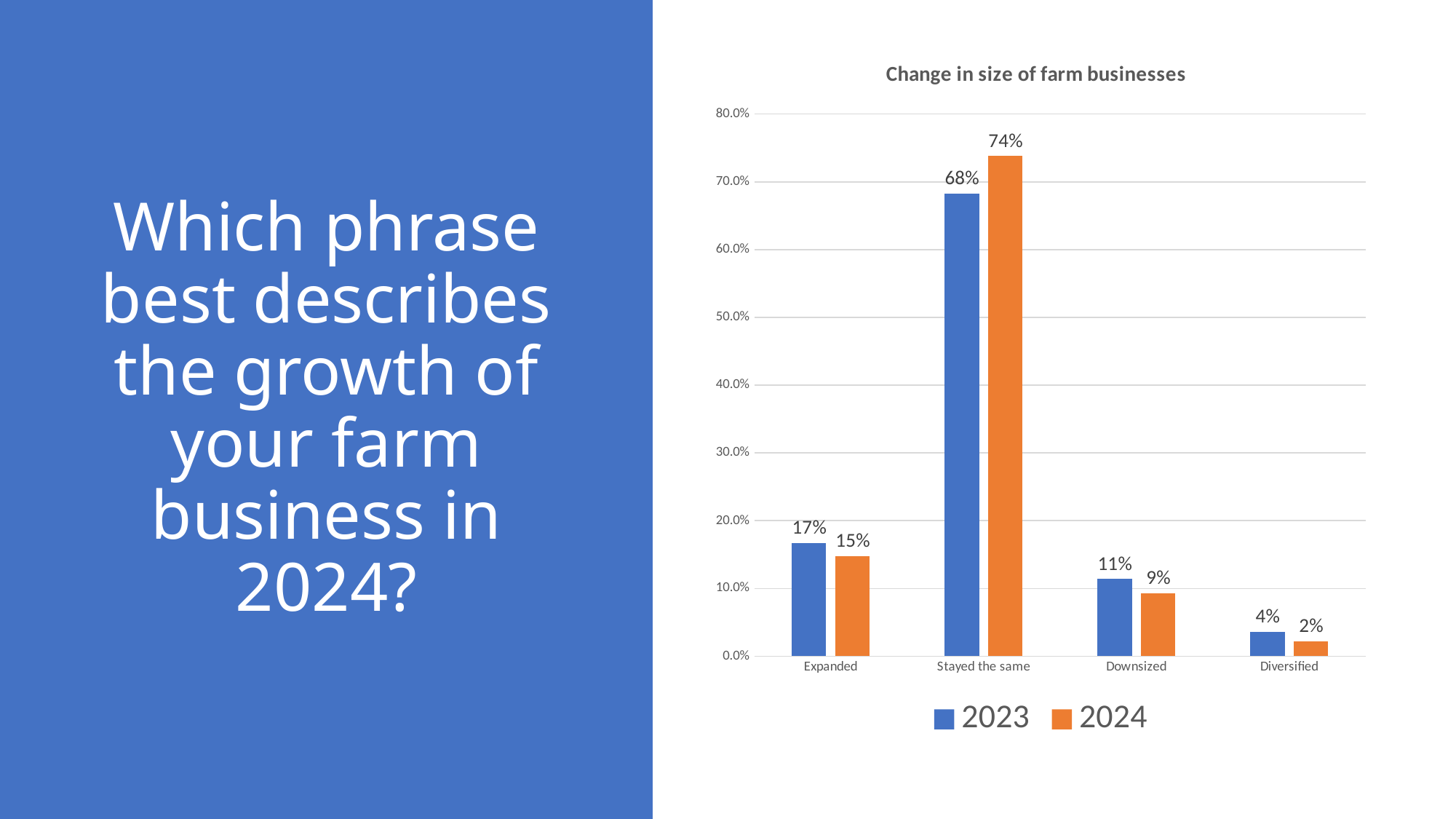
Is the 2024 value for Expanded greater or less than 20.0%? less What is the 2023 value for Diversified? 4% What is the 2023 value for Expanded? 17% Which category has the highest 2023 value? Stayed the same What is the 2024 value for Downsized? 9% How many series does the legend list? 2 How many categories are shown on the x axis? 4 What is the difference between the 2024 and 2023 values for Stayed the same? 6% What kind of chart is shown? bar chart Which category has the lowest 2024 value? Diversified Which is larger for Downsized, the 2023 value or the 2024 value? 2023 What is the 2024 value for Stayed the same? 74%